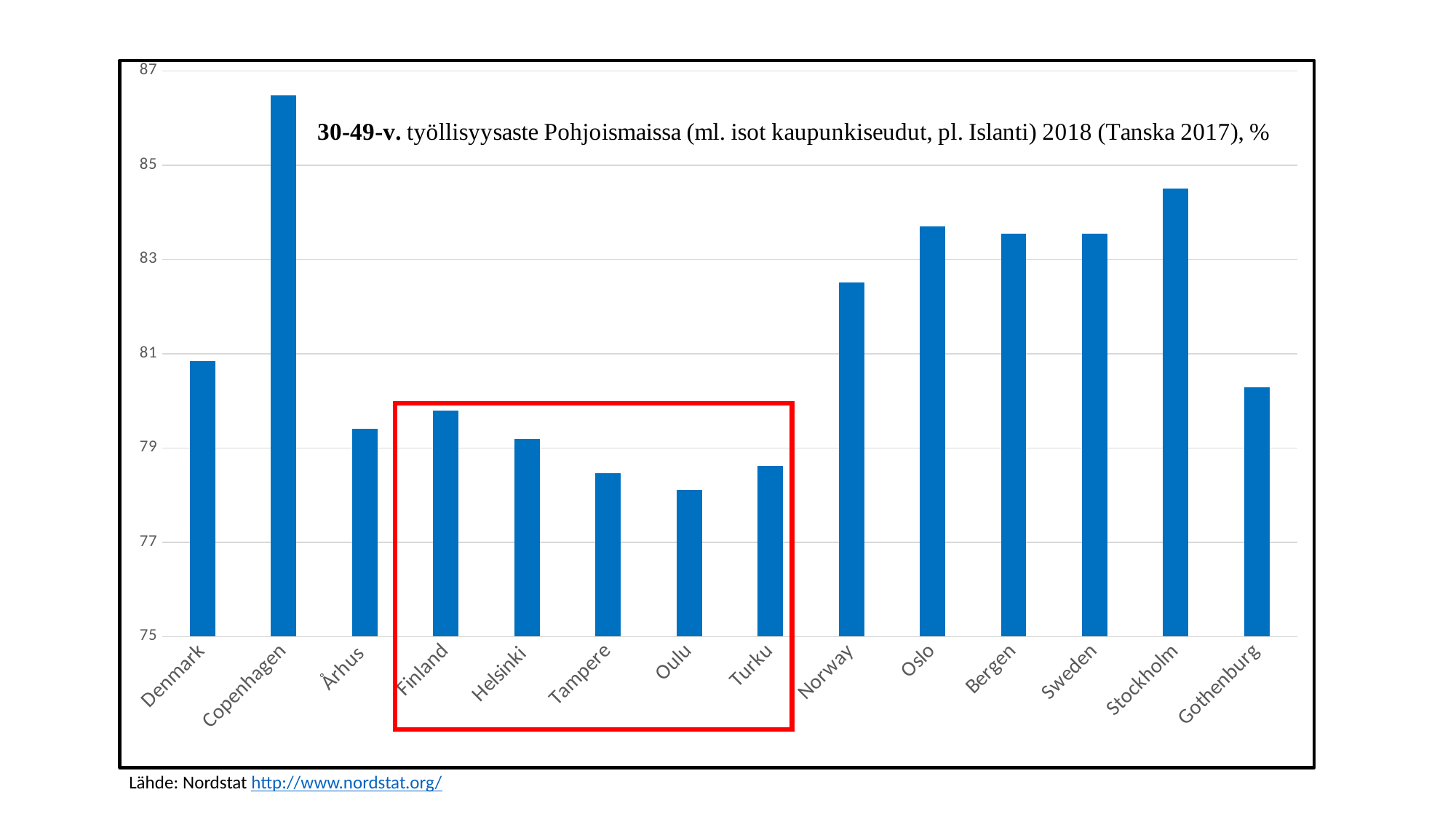
What kind of chart is shown on the slide? bar chart Which category has the highest employment rate? Copenhagen Which category has the lowest employment rate? Oulu Is the value for Finland greater or less than 79? greater Which is higher, the value for Norway or the value for Finland? Norway Which categories are enclosed by the red box on the chart? Finland, Helsinki, Tampere, Oulu, Turku Is the value for Copenhagen greater or less than 85? greater Is the value for Oulu greater or less than 79? less How many categories are plotted on the x axis? 14 Which is higher, the value for Oslo or the value for Gothenburg? Oslo